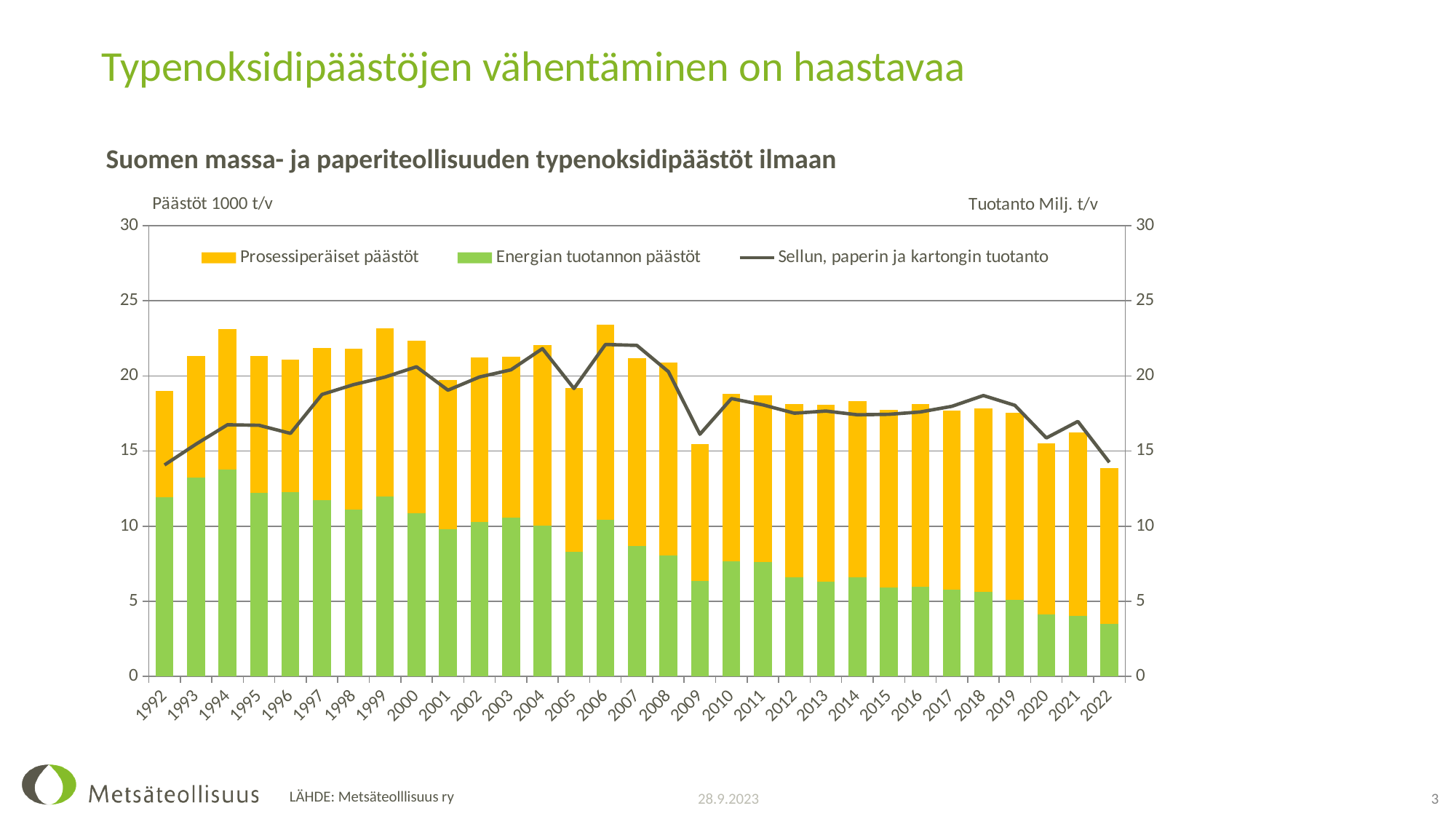
How many series does the legend list? 3 Which year has the larger total emissions bar, 1992 or 2022? 1992 Is the value for Energian tuotannon päästöt in 1993 greater or less than 10? greater Which year has the lowest total emissions bar? 2022 Do the values for Energian tuotannon päästöt generally rise or fall from 1992 to 2022? fall What kind of chart is shown on the slide? bar chart (stacked, with a line) How many years are shown on the x axis? 31 Is the total emissions bar for 2006 greater or less than 20? greater Which year has the lowest value for Energian tuotannon päästöt? 2022 Is the Sellun, paperin ja kartongin tuotanto line in 2006 greater or less than 20? greater